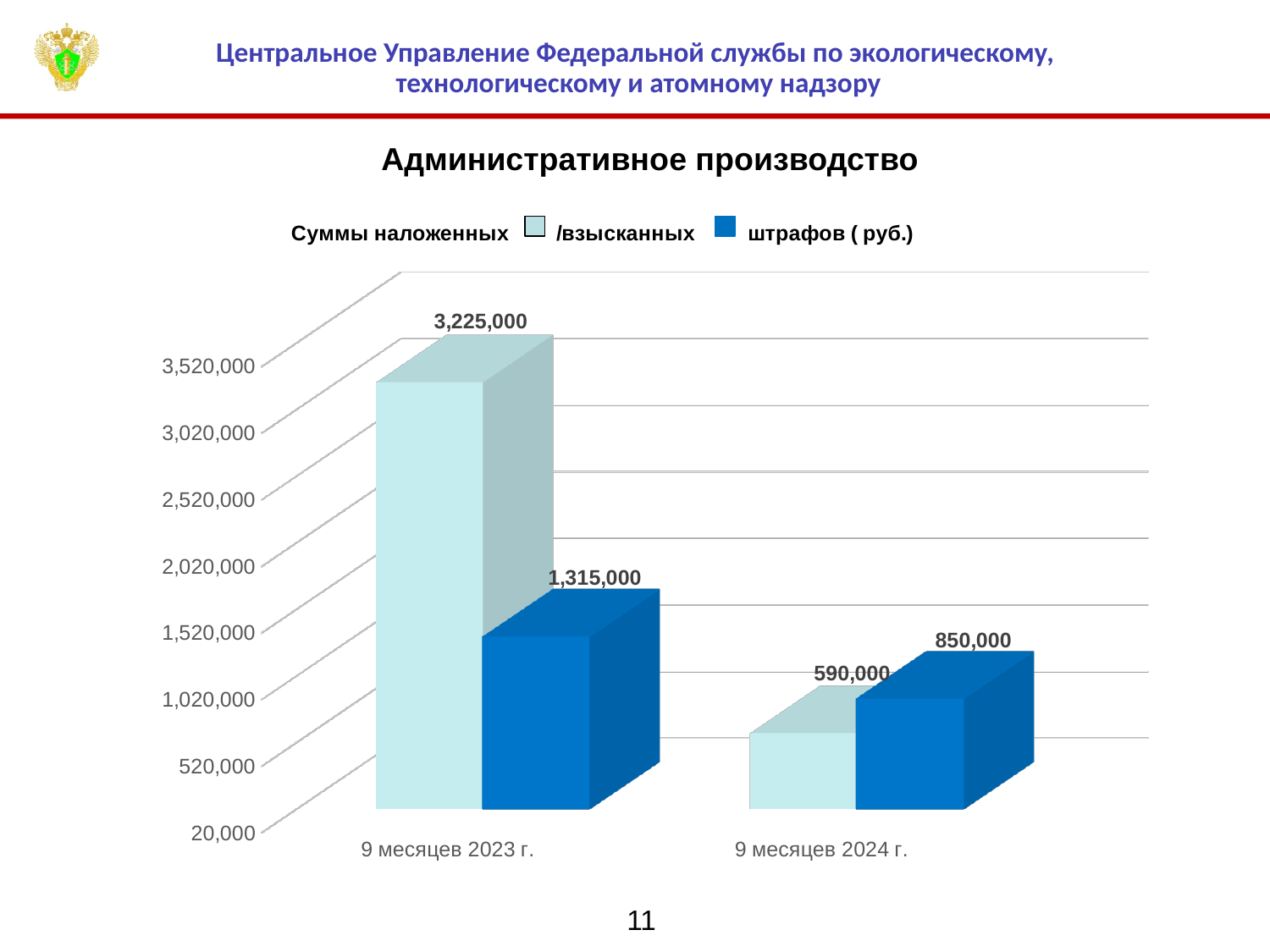
What is the value of the collected fines (взысканных) for 9 месяцев 2023 г.? 1,315,000 What is the value of the imposed fines (наложенных) for 9 месяцев 2023 г.? 3,225,000 What kind of chart is shown on the slide? Bar chart How many series does the legend list? 2 What is the value of the imposed fines (наложенных) for 9 месяцев 2024 г.? 590,000 How many categories are shown on the x axis? 2 What is the difference between the imposed and collected fines for 9 месяцев 2023 г.? 1,910,000 What is the value of the collected fines (взысканных) for 9 месяцев 2024 г.? 850,000 What is the difference between the imposed fines for 9 месяцев 2023 г. and 9 месяцев 2024 г.? 2,635,000 Which bar on the chart has the highest value? наложенных, 9 месяцев 2023 г. Which bar on the chart has the lowest value? наложенных, 9 месяцев 2024 г. Which is larger for 9 месяцев 2024 г.: the imposed fines (наложенных) or the collected fines (взысканных)? взысканных